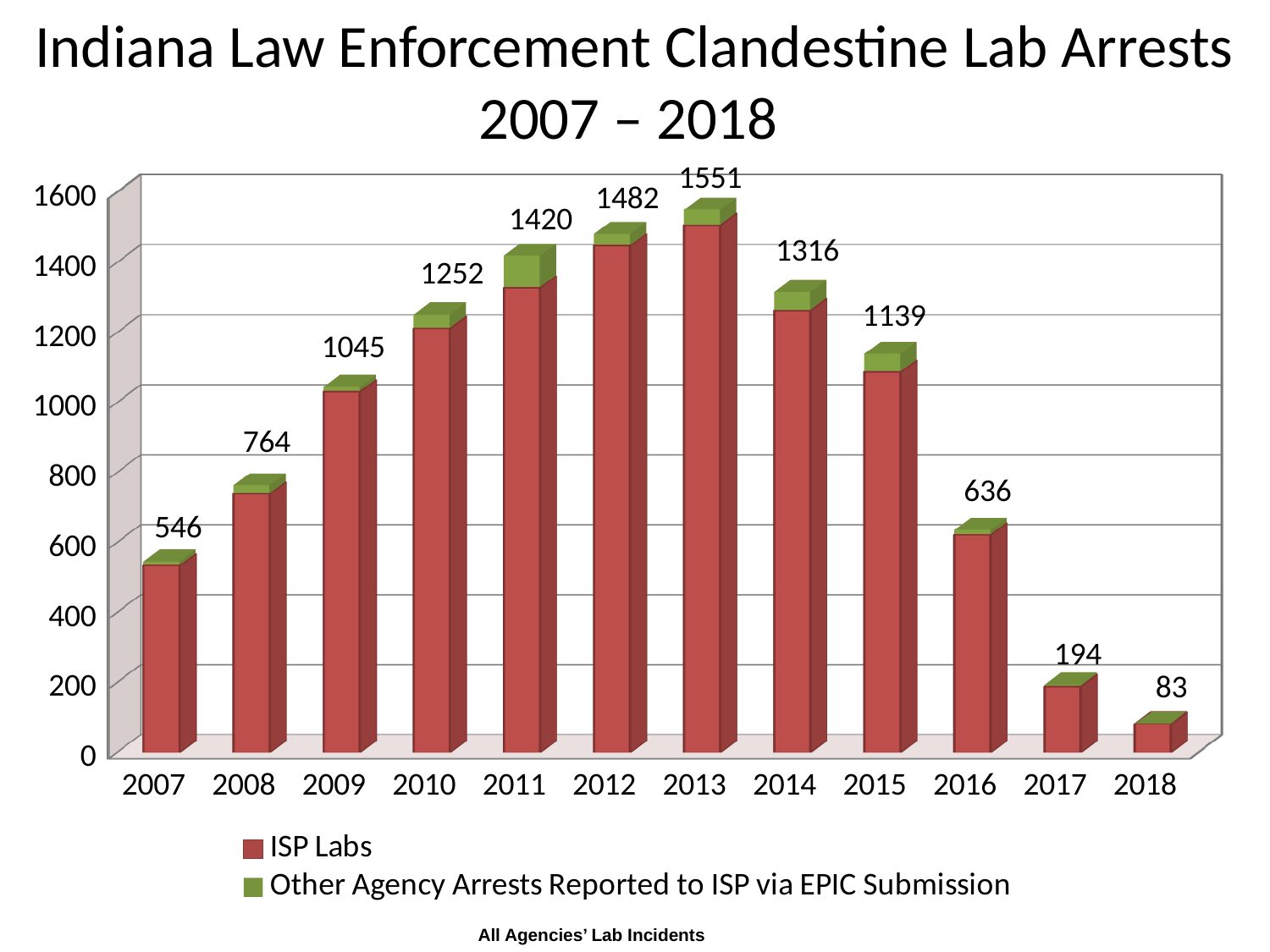
Which year has a larger total of arrests, 2010 or 2014? 2014 What kind of chart is shown on the slide? Stacked bar chart How many years are shown on the x axis? 12 Is the ISP Labs portion of the 2013 bar greater or less than 1400? greater What is the total number of clandestine lab arrests shown for 2017? 194 Which year has the lowest total number of arrests? 2018 How many series does the legend list? 2 Do the total arrests rise or fall from 2013 to 2018? Fall What is the total number of clandestine lab arrests shown for 2010? 1252 Which year has the highest total number of arrests? 2013 What is the difference between the total arrests in 2013 and 2012? 69 What is the difference between the total arrests in 2016 and 2017? 442